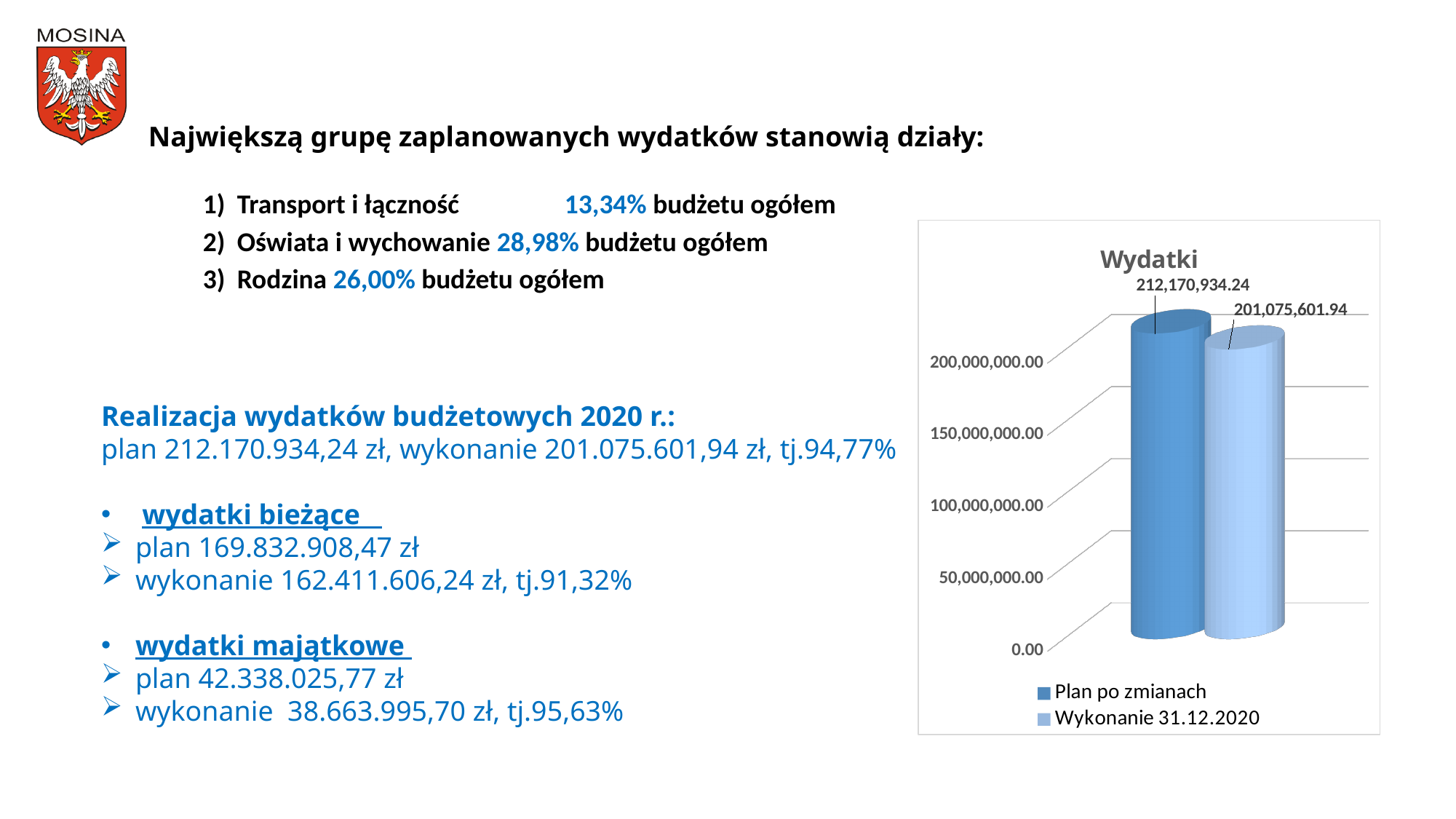
What is the title of the chart on the slide? Wydatki Which series has the higher value in the Wydatki chart? Plan po zmianach In the Wydatki chart, is the value for Plan po zmianach larger or smaller than the value for Wykonanie 31.12.2020? larger What is the value of the Plan po zmianach bar in the Wydatki chart? 212,170,934.24 Is the value for Wykonanie 31.12.2020 in the Wydatki chart greater or less than 200,000,000.00? greater Is the value for Plan po zmianach in the Wydatki chart greater or less than 150,000,000.00? greater What is the difference between the Plan po zmianach value and the Wykonanie 31.12.2020 value in the Wydatki chart? 11,095,332.30 What is the value of the Wykonanie 31.12.2020 bar in the Wydatki chart? 201,075,601.94 How many series does the legend of the Wydatki chart list? 2 How many bars are plotted in the Wydatki chart? 2 What kind of chart is the Wydatki chart? bar chart Which series has the lower value in the Wydatki chart? Wykonanie 31.12.2020